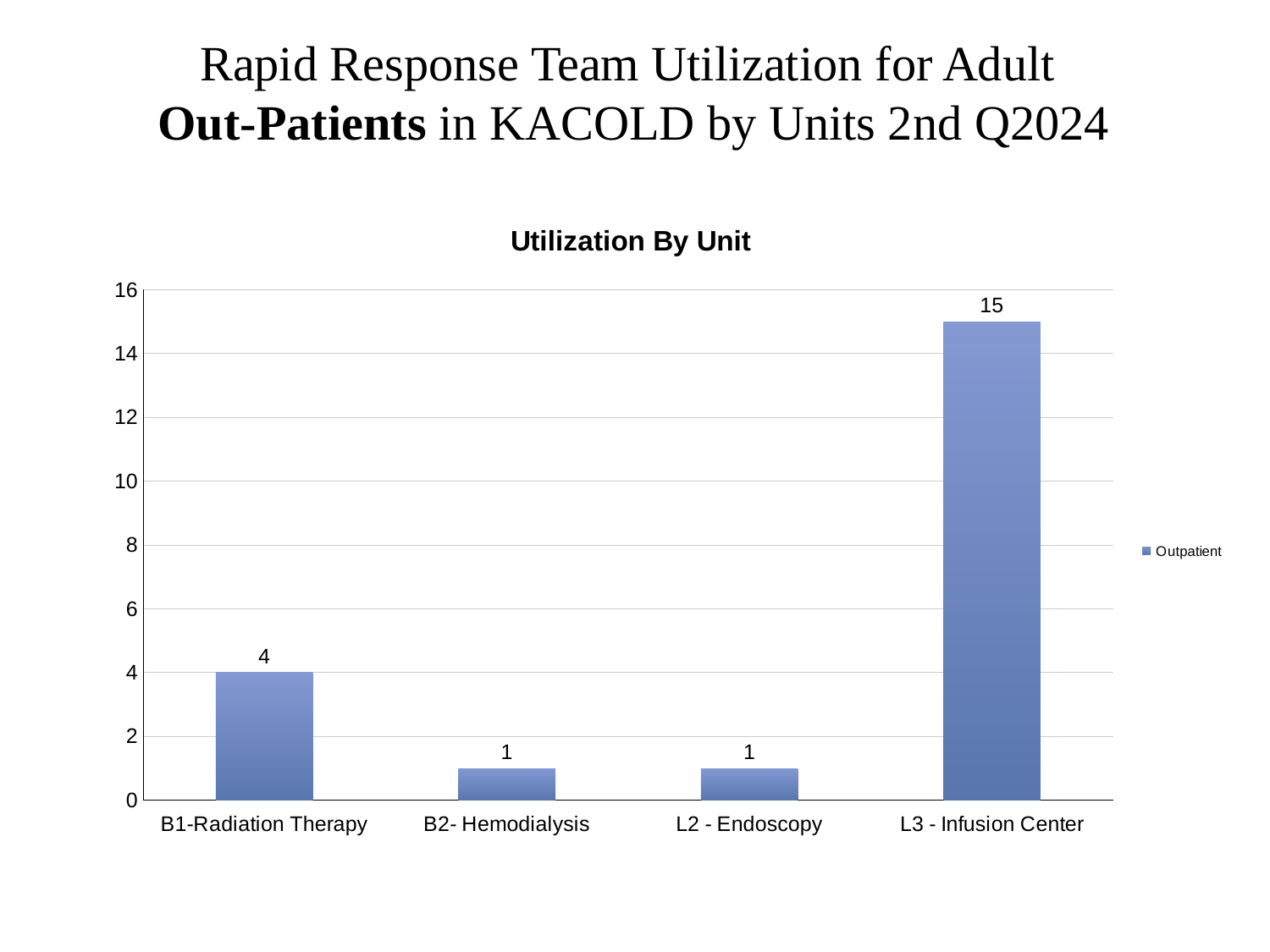
Which unit has the highest value? L3 - Infusion Center What is the value for B2- Hemodialysis? 1 What is the difference between the values for L3 - Infusion Center and B1-Radiation Therapy? 11 How many units are shown on the x axis? 4 How many series does the legend list? 1 What kind of chart is shown? bar chart Is the value for L3 - Infusion Center greater or less than 10? greater What series name is shown in the legend? Outpatient What is the value for L3 - Infusion Center? 15 Which is larger, the value for B1-Radiation Therapy or the value for L2 - Endoscopy? B1-Radiation Therapy What is the title of the chart? Utilization By Unit What is the value for B1-Radiation Therapy? 4